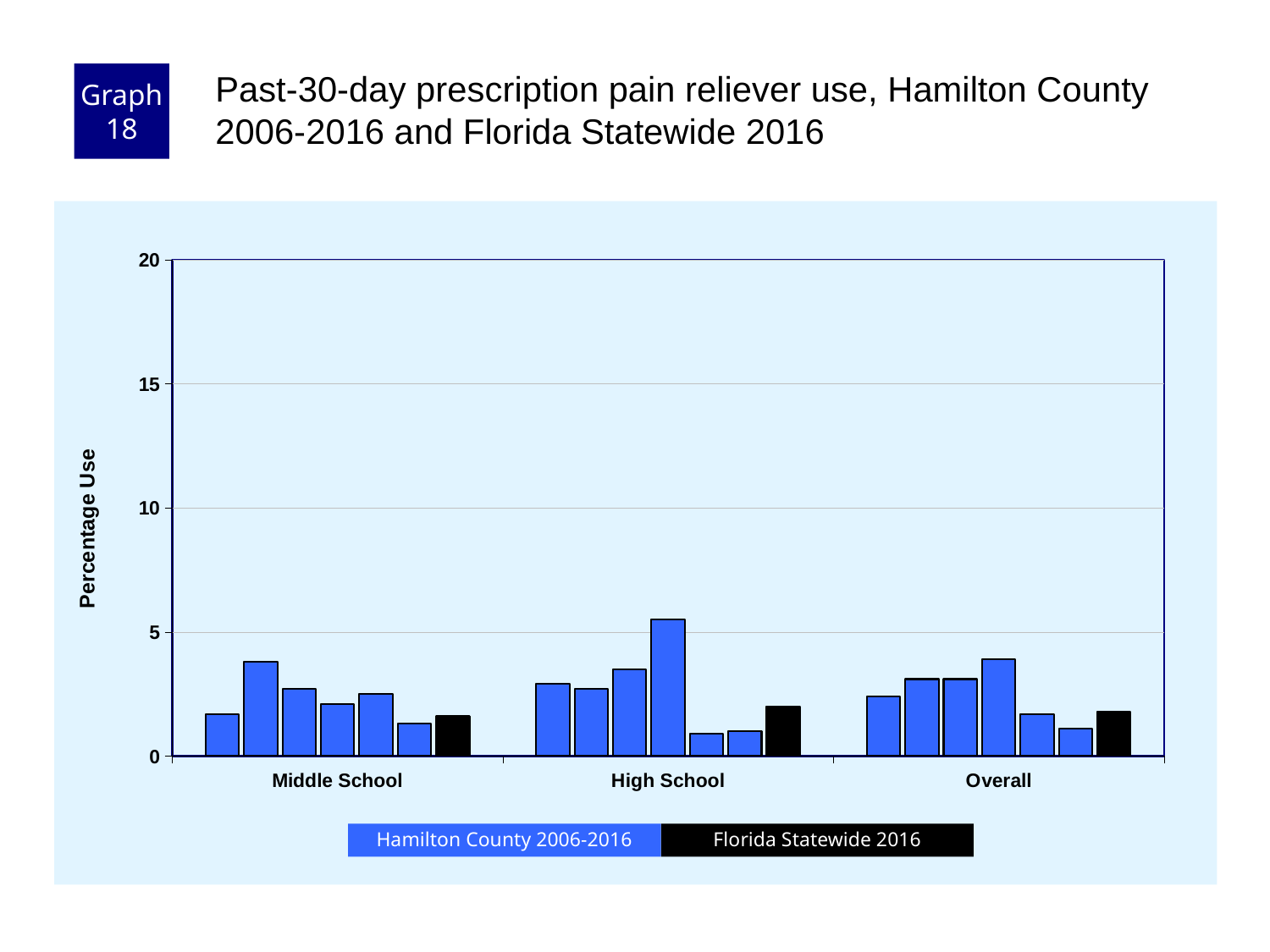
What kind of chart is shown on the slide? bar chart What is the label of the y axis? Percentage Use Is the tallest bar in the High School group greater or less than 5? greater Is any bar in the chart greater than 10? No How many category groups are shown on the x axis? 3 Which category group contains the tallest bar in the chart? High School In the High School group, is the Florida Statewide 2016 bar taller or shorter than the tallest Hamilton County bar? shorter What is the highest value shown on the y axis? 20 Is the tallest bar in the Overall group greater or less than 5? less How many series does the legend list? 2